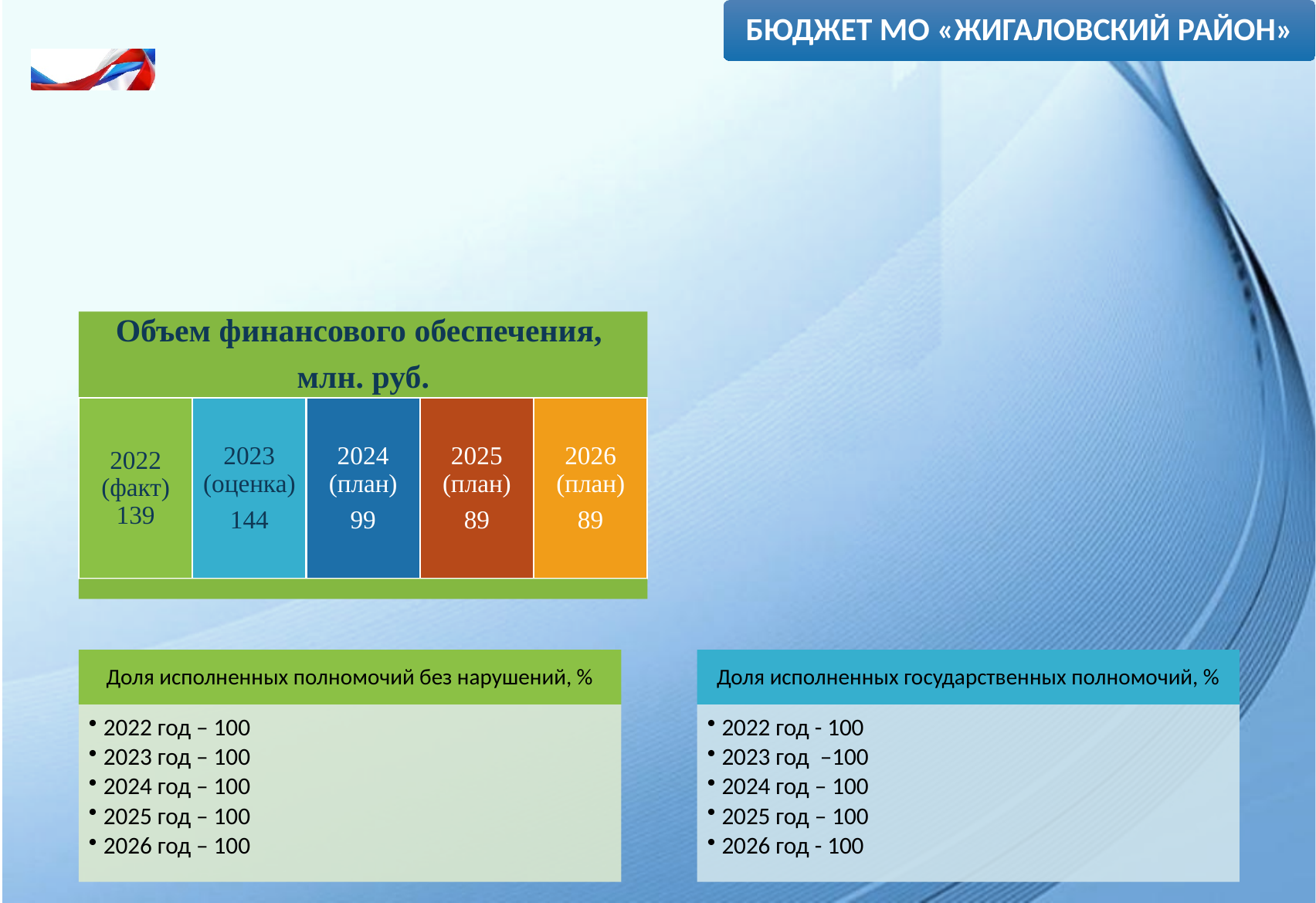
What is the value for 2026 (план) in the 'Объем финансового обеспечения, млн. руб.' graphic? 89 In the 'Объем финансового обеспечения, млн. руб.' graphic, which is larger: the value for 2022 (факт) or 2023 (оценка)? 2023 (оценка) Do the values in the 'Объем финансового обеспечения, млн. руб.' graphic rise or fall from 2023 to 2026? fall What is the value for 2023 (оценка) in the 'Объем финансового обеспечения, млн. руб.' graphic? 144 What colour is the 2024 (план) block in the 'Объем финансового обеспечения, млн. руб.' graphic? blue Which year has the highest value in the 'Объем финансового обеспечения, млн. руб.' graphic? 2023 (оценка) What is the difference between the 2022 (факт) and 2025 (план) values in the 'Объем финансового обеспечения, млн. руб.' graphic? 50 How many years are shown in the 'Объем финансового обеспечения, млн. руб.' graphic? 5 What is the difference between the 2023 (оценка) and 2024 (план) values in the 'Объем финансового обеспечения, млн. руб.' graphic? 45 What is the value for 2022 (факт) in the 'Объем финансового обеспечения, млн. руб.' graphic? 139 What is the value for 2024 (план) in the 'Объем финансового обеспечения, млн. руб.' graphic? 99 What unit is given in the title of the 'Объем финансового обеспечения' graphic? млн. руб.